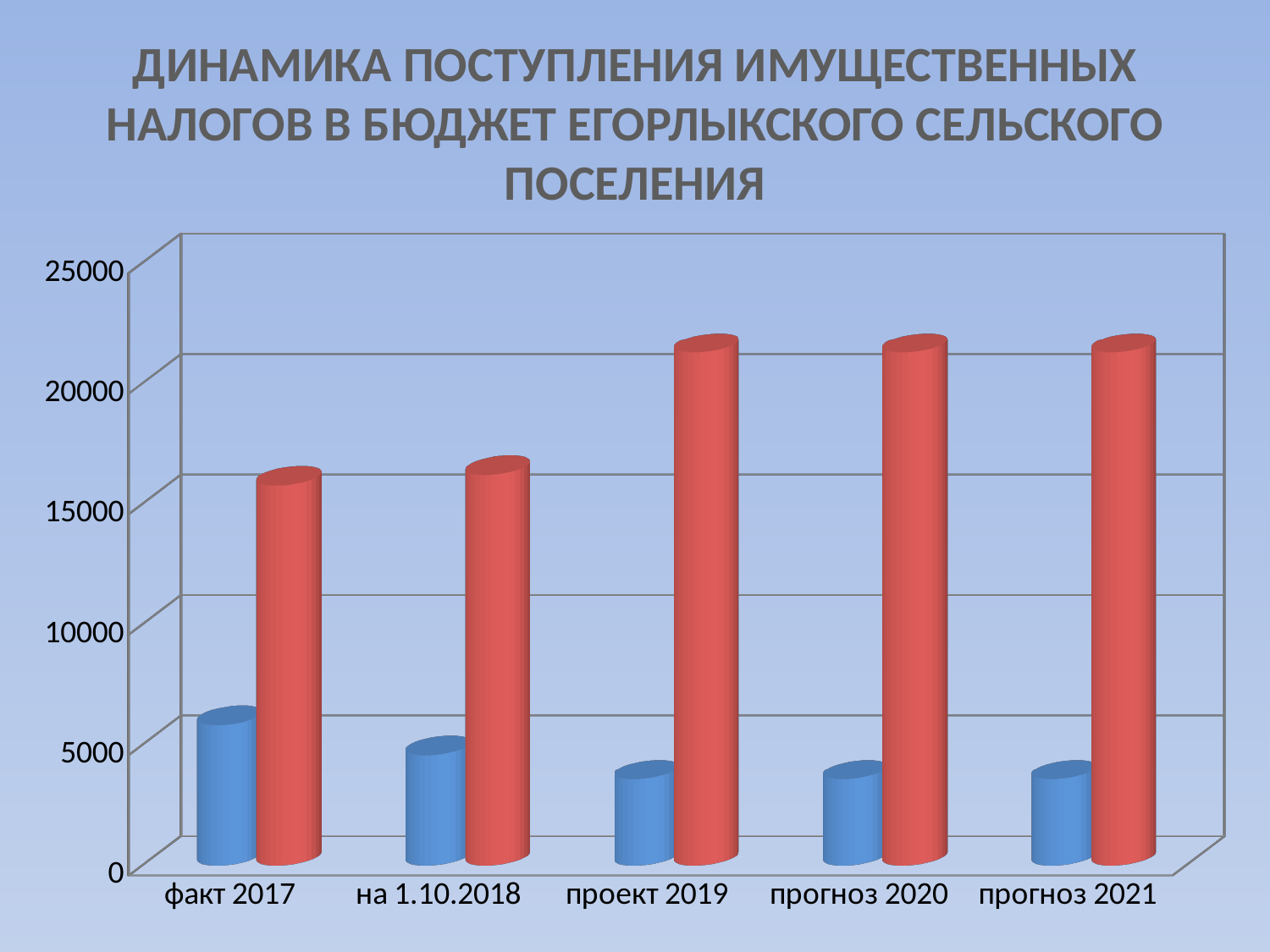
Which blue bar is larger, факт 2017 or на 1.10.2018? факт 2017 Do the red bars generally rise or fall from факт 2017 to прогноз 2021? rise How many categories are shown along the x axis? 5 Is the value of the red bar for факт 2017 greater or less than 20000? less Is the value of the blue bar for факт 2017 greater or less than 5000? greater For прогноз 2020, which bar is larger, the blue one or the red one? the red one Which category has the highest blue bar? факт 2017 How many data series (bar colours) are plotted for each category? 2 What kind of chart is shown on the slide? bar chart What is the first word of the chart title on the slide? ДИНАМИКА Is the value of the blue bar for проект 2019 greater or less than 5000? less